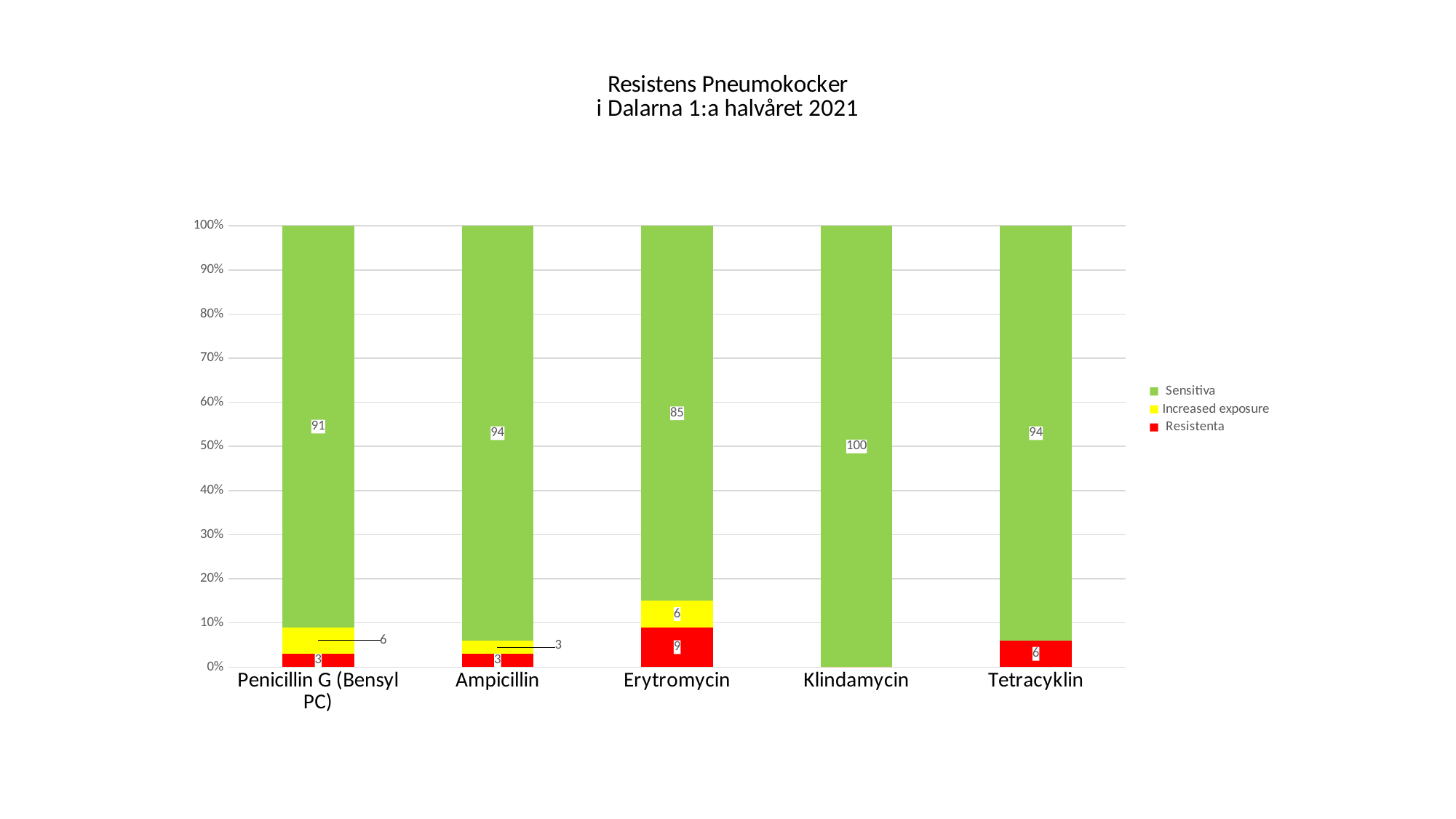
What is the Resistenta value for Tetracyklin? 6 Which antibiotic has the highest Sensitiva value? Klindamycin What is the difference between the Sensitiva values for Ampicillin and Erytromycin? 9 Which is larger, the Resistenta value for Erytromycin or for Tetracyklin? Erytromycin What is the Sensitiva value for Erytromycin? 85 What is the Increased exposure value for Penicillin G (Bensyl PC)? 6 What is the Resistenta value for Erytromycin? 9 Which colour represents the Resistenta series? Red Which antibiotic has the lowest Sensitiva value? Erytromycin How many antibiotics are shown on the x axis? 5 How many series does the legend list? 3 What kind of chart is shown on the slide? Stacked bar chart